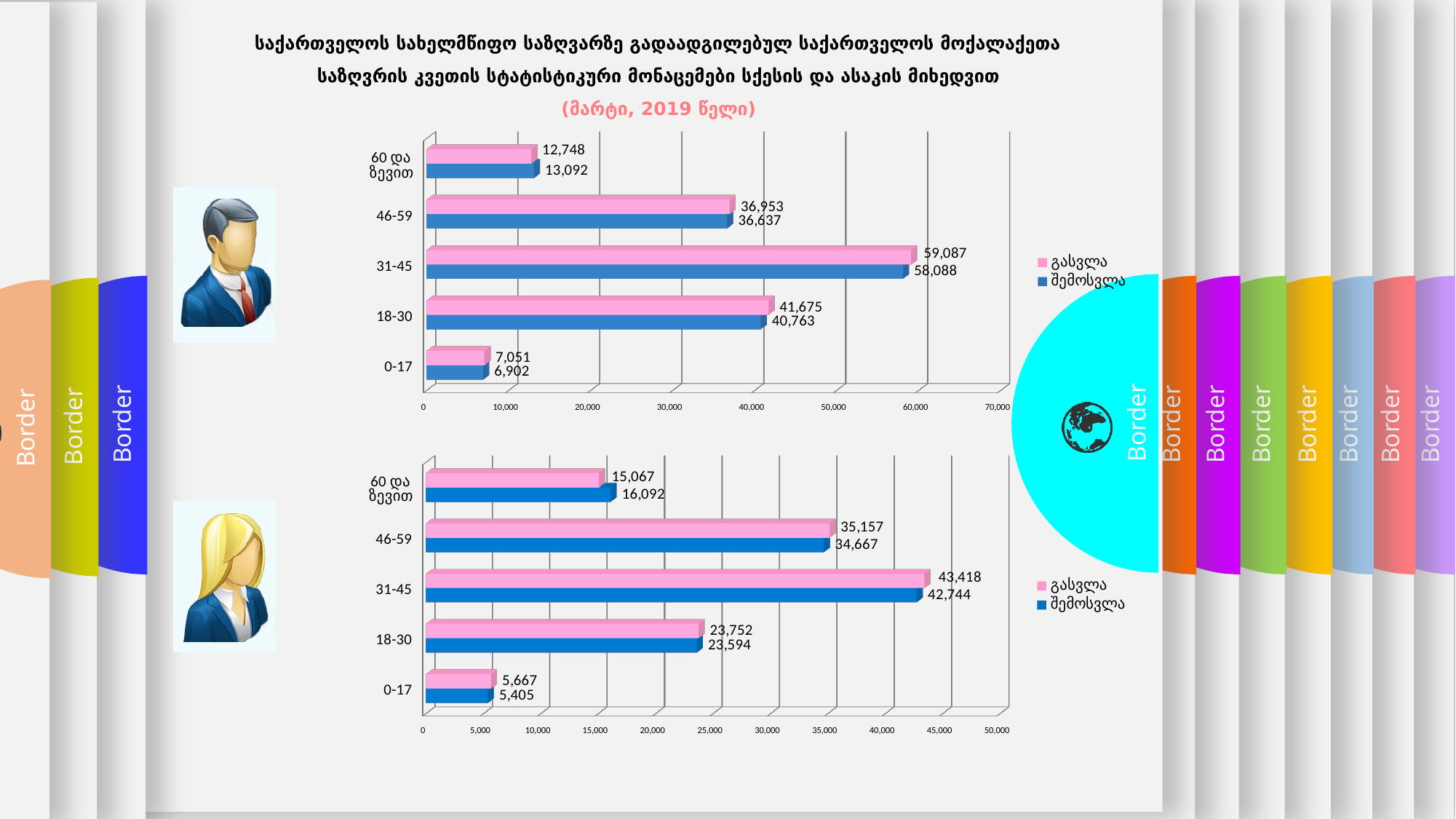
In the top chart, which is larger for the 60 და ზევით age group: გასვლა or შემოსვლა? შემოსვლა In the bottom chart, what is the difference between the შემოსვლა and გასვლა values for the 60 და ზევით age group? 1,025 In the top chart, what is the შემოსვლა value for the 18-30 age group? 40,763 How many series does the legend of the top chart list? 2 In the bottom chart, what is the გასვლა value for the 0-17 age group? 5,667 In the bottom chart, which age group has the lowest შემოსვლა value? 0-17 What type of chart is the bottom chart? Bar chart In the top chart, what is the difference between the გასვლა and შემოსვლა values for the 31-45 age group? 999 In the bottom chart, what is the შემოსვლა value for the 60 და ზევით age group? 16,092 How many age groups are shown in the bottom chart? 5 In the top chart, which age group has the highest გასვლა value? 31-45 In the top chart, what is the გასვლა value for the 31-45 age group? 59,087